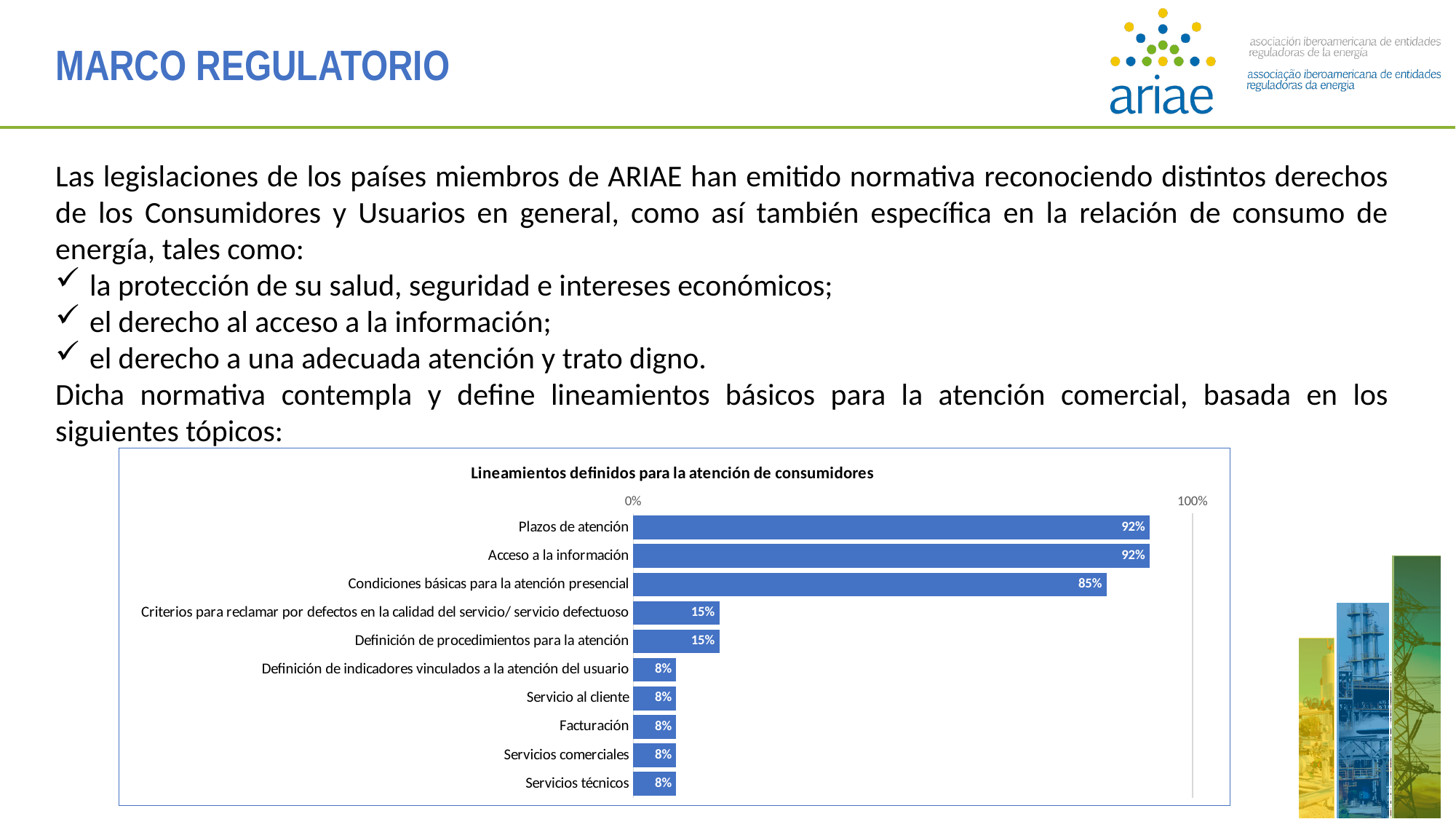
What is the value for Facturación? 8% Which is larger, the value for Condiciones básicas para la atención presencial or the value for Definición de procedimientos para la atención? Condiciones básicas para la atención presencial What kind of chart is shown on the slide? Bar chart What is the value for Plazos de atención? 92% How many categories are shown in the chart? 10 What is the value for Servicios técnicos? 8% What is the difference between the values for Criterios para reclamar por defectos en la calidad del servicio/ servicio defectuoso and Servicio al cliente? 7% What is the title of the chart? Lineamientos definidos para la atención de consumidores What is the difference between the values for Acceso a la información and Condiciones básicas para la atención presencial? 7% What is the value for Condiciones básicas para la atención presencial? 85% How many categories have a value of 8%? 5 What is the value for Definición de procedimientos para la atención? 15%